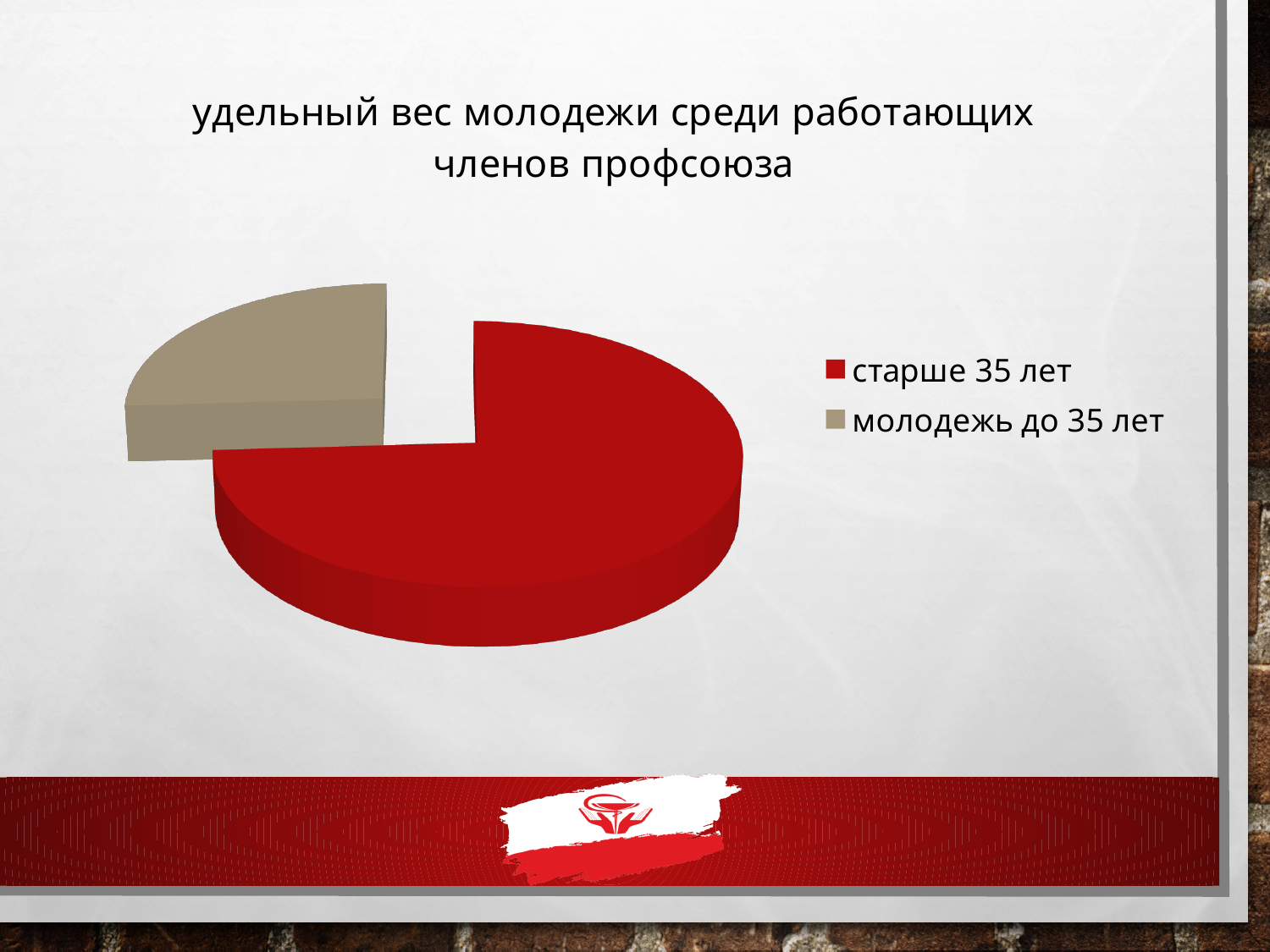
What colour is the slice for "молодежь до 35 лет" in the pie chart? beige How many entries does the legend of the pie chart list? 2 Which category has the smallest slice of the pie chart? молодежь до 35 лет Which category has the largest slice of the pie chart? старше 35 лет How many slices does the pie chart have? 2 Which slice is larger: "старше 35 лет" or "молодежь до 35 лет"? старше 35 лет What is the title of the chart on the slide? удельный вес молодежи среди работающих членов профсоюза What kind of chart is shown on the slide? pie chart